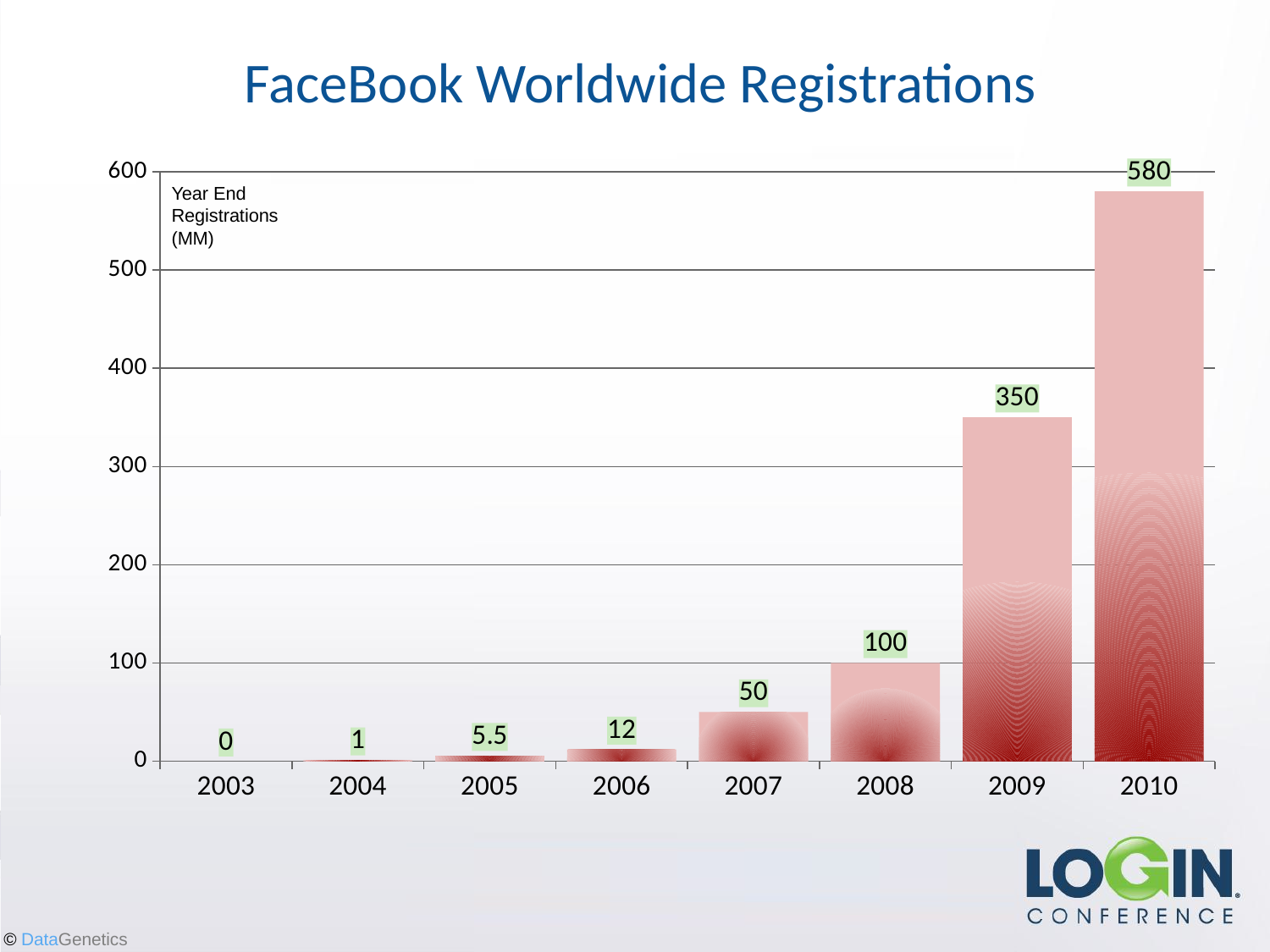
Is the value for 2009 greater or less than 300? greater How many years are shown on the x axis? 8 What is the difference between the values for 2008 and 2007? 50 Do the values rise or fall from 2003 to 2010? rise What is the value for 2005? 5.5 Which year has the lowest value? 2003 Which is larger, the value for 2006 or the value for 2008? 2008 What kind of chart is shown? bar chart What is the value for 2010? 580 What is the value for 2007? 50 Which year has the highest value? 2010 What is the difference between the values for 2010 and 2009? 230